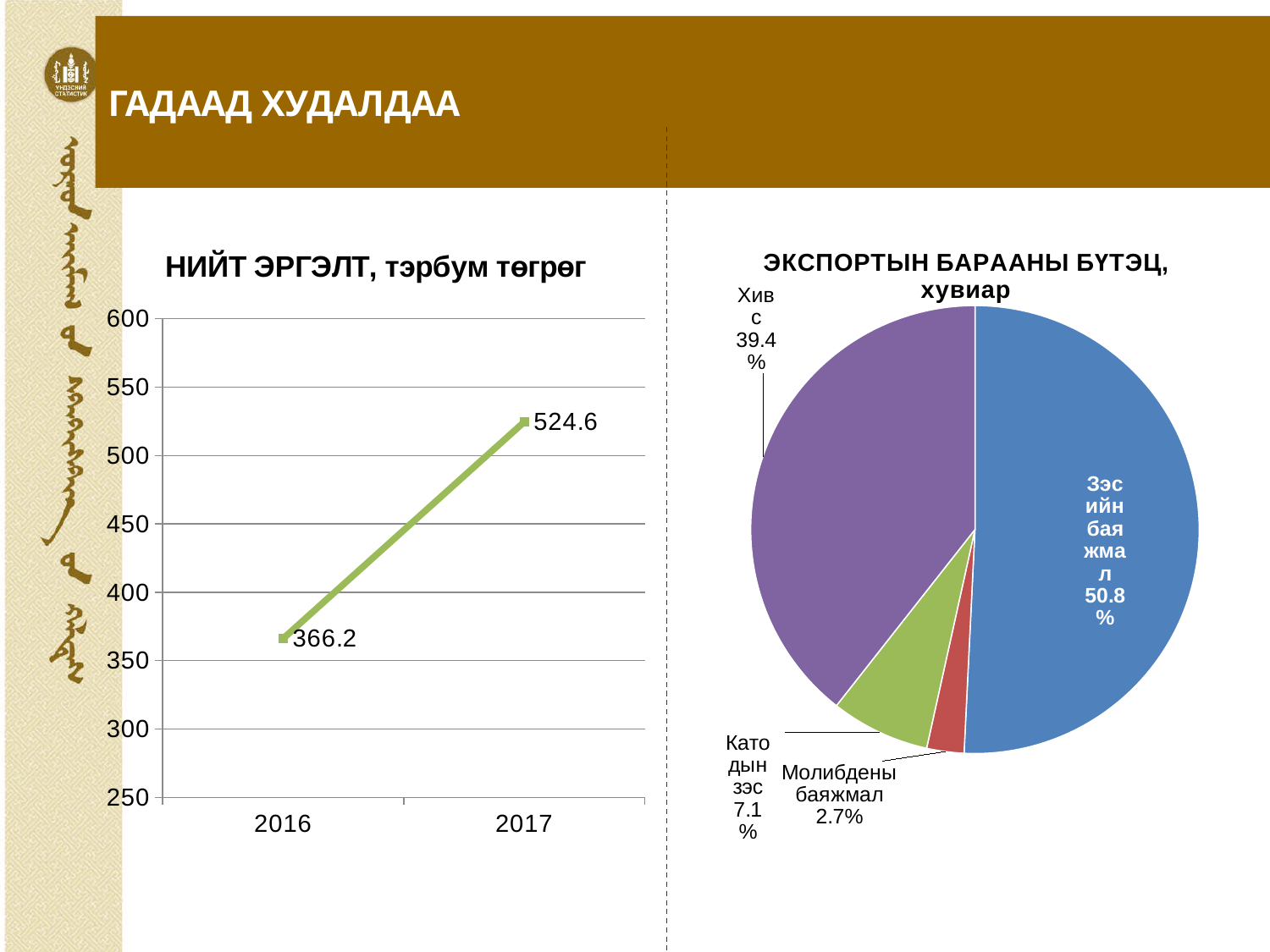
In the pie chart titled 'ЭКСПОРТЫН БАРААНЫ БҮТЭЦ, хувиар', which category has the smallest slice? Молибдены баяжмал In the line chart titled 'НИЙТ ЭРГЭЛТ, тэрбум төгрөг', what is the value for 2016? 366.2 What kind of chart is the chart on the right of the slide, titled 'ЭКСПОРТЫН БАРААНЫ БҮТЭЦ, хувиар'? pie chart In the pie chart titled 'ЭКСПОРТЫН БАРААНЫ БҮТЭЦ, хувиар', what share does 'Хивс' have? 39.4% In the pie chart titled 'ЭКСПОРТЫН БАРААНЫ БҮТЭЦ, хувиар', what share does 'Зэсийн баяжмал' have? 50.8% What kind of chart is the chart on the left of the slide, titled 'НИЙТ ЭРГЭЛТ, тэрбум төгрөг'? line chart In the line chart titled 'НИЙТ ЭРГЭЛТ, тэрбум төгрөг', how many years are plotted? 2 In the pie chart titled 'ЭКСПОРТЫН БАРААНЫ БҮТЭЦ, хувиар', which category has the largest slice? Зэсийн баяжмал In the line chart titled 'НИЙТ ЭРГЭЛТ, тэрбум төгрөг', does the value rise or fall from 2016 to 2017? rise In the pie chart titled 'ЭКСПОРТЫН БАРААНЫ БҮТЭЦ, хувиар', how many slices are there? 4 In the line chart titled 'НИЙТ ЭРГЭЛТ, тэрбум төгрөг', what is the value for 2017? 524.6 In the line chart titled 'НИЙТ ЭРГЭЛТ, тэрбум төгрөг', what is the difference between the 2017 and 2016 values? 158.4